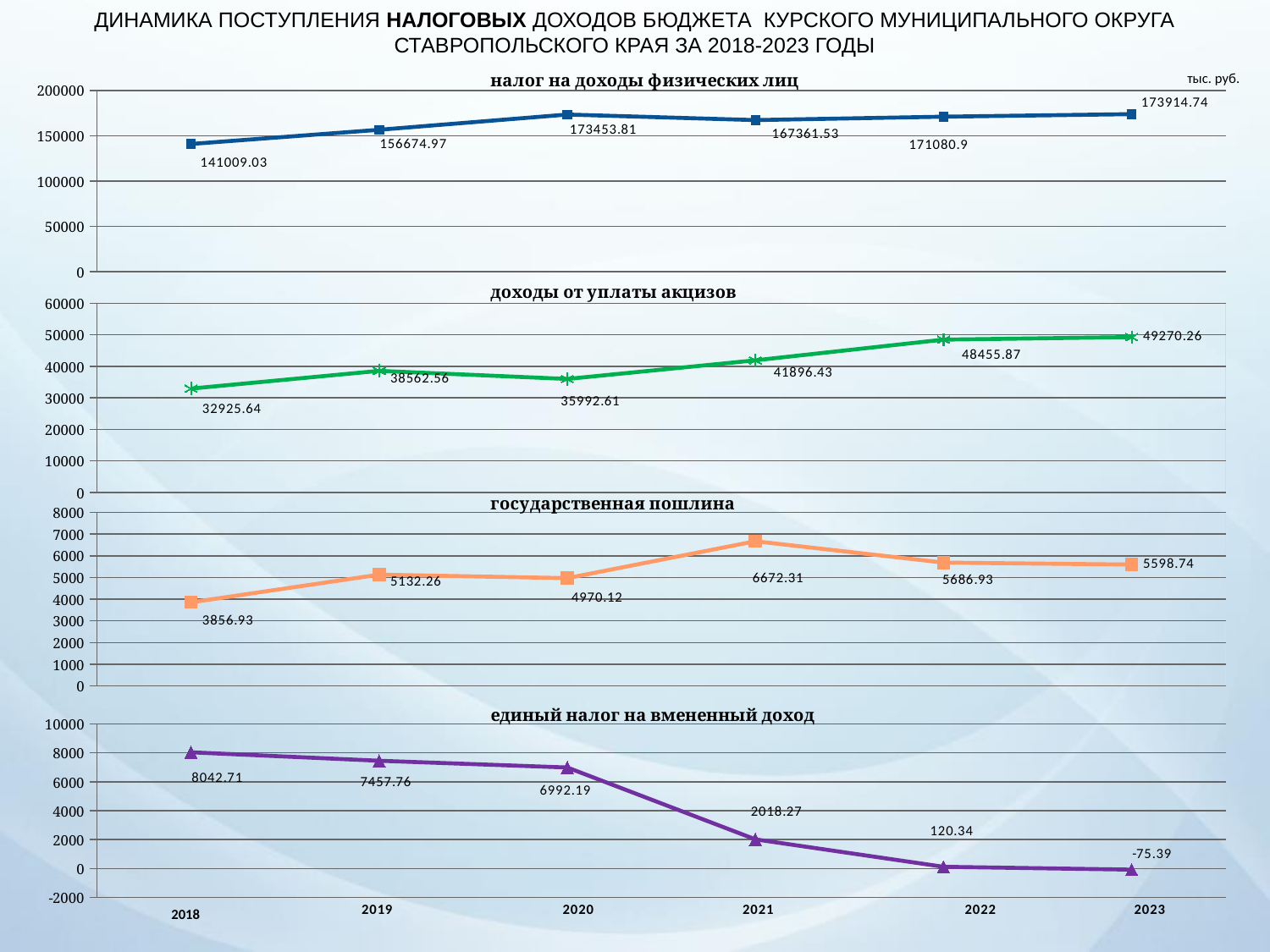
On the chart titled 'единый налог на вмененный доход', what is the value for 2023? -75.39 On the chart titled 'единый налог на вмененный доход', what is the difference between the 2018 value and the 2019 value? 584.95 On the chart titled 'единый налог на вмененный доход', do the values rise or fall from 2018 to 2023? fall What kind of chart is the chart titled 'государственная пошлина'? line chart On the chart titled 'налог на доходы физических лиц', which year has the lowest value? 2018 On the chart titled 'государственная пошлина', what is the value for 2020? 4970.12 On the chart titled 'государственная пошлина', which year has the highest value? 2021 On the chart titled 'налог на доходы физических лиц', which is larger, the value for 2020 or the value for 2021? 2020 On the chart titled 'доходы от уплаты акцизов', what is the value for 2022? 48455.87 On the chart titled 'доходы от уплаты акцизов', what is the difference between the 2023 value and the 2018 value? 16344.62 On the chart titled 'налог на доходы физических лиц', what is the value for 2018? 141009.03 How many data points are plotted on the chart titled 'доходы от уплаты акцизов'? 6